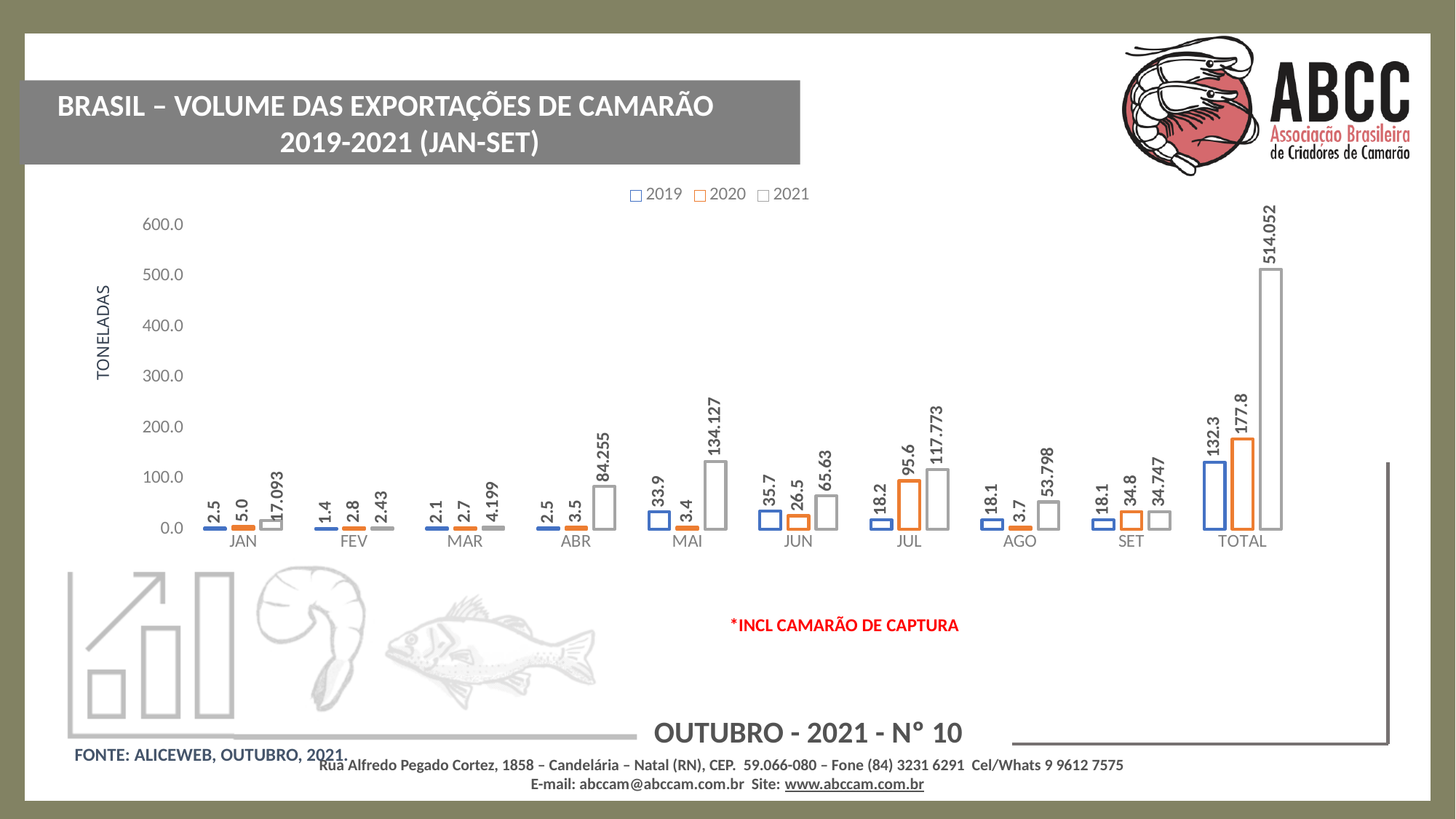
Is the 2021 value for JUL greater or less than 100.0? greater Which month has the lowest 2019 value? FEV What is the 2020 value for JUL? 95.6 What is the 2021 value for MAI? 134.127 What kind of chart is shown on the slide? bar chart Which is larger for JUN: the 2019 value or the 2020 value? 2019 How many categories are shown on the x axis? 10 Which month has the highest 2021 value (excluding TOTAL)? MAI What is the difference between the 2020 and 2019 TOTAL values? 45.5 How many series does the legend list? 3 What is the 2021 TOTAL value? 514.052 What is the 2019 value for JUN? 35.7